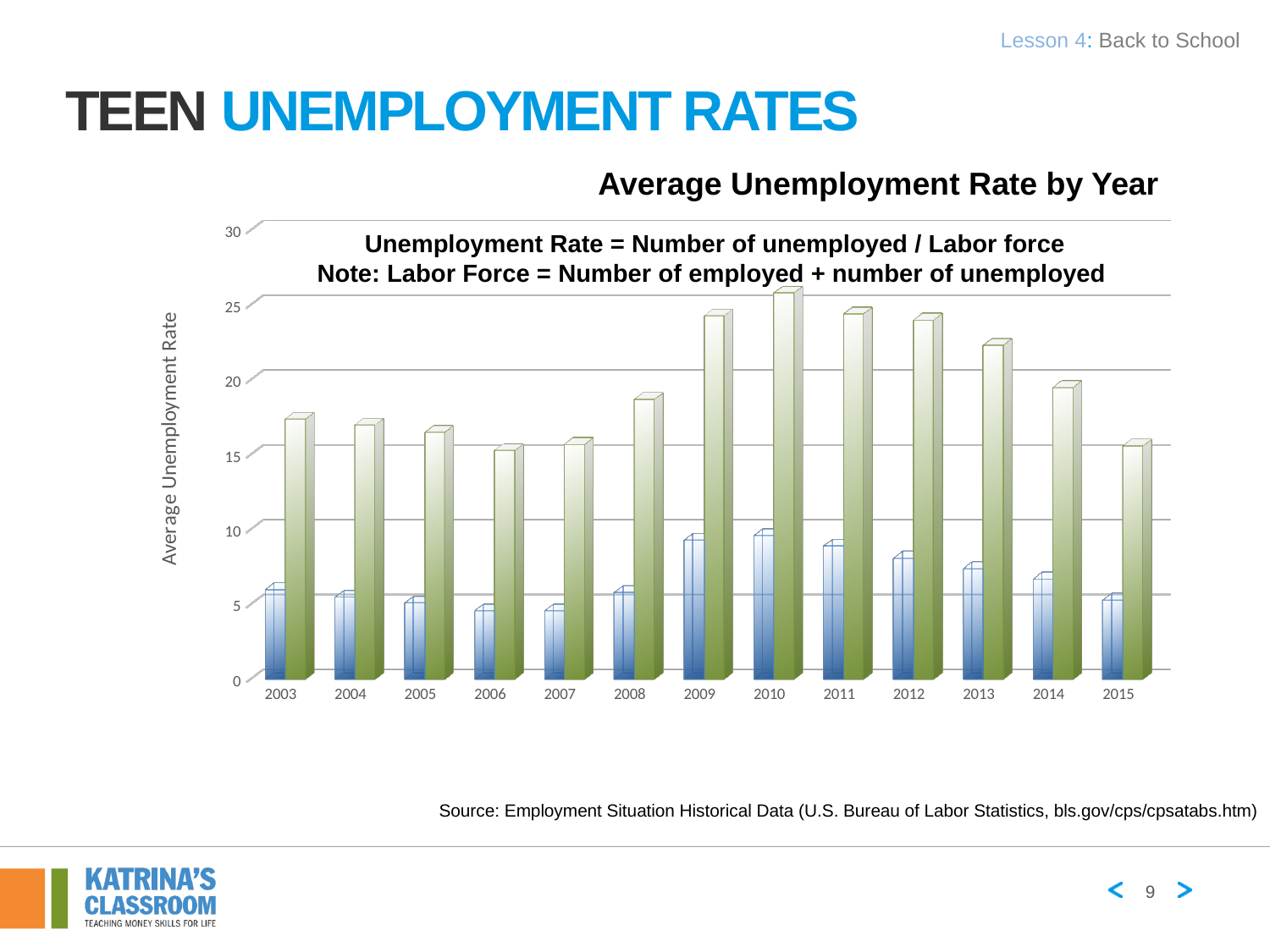
Which is taller, the blue bar for 2004 or the blue bar for 2009? 2009 How many years are shown along the x axis of the chart? 13 Is the green bar for 2006 greater or less than 20? less Do the green bars rise or fall from 2010 to 2015? fall Which is taller, the green bar for 2009 or the green bar for 2003? 2009 What kind of chart is shown on the slide? Bar chart What is the title of the chart? Average Unemployment Rate by Year What is the label on the vertical axis of the chart? Average Unemployment Rate Which year has the tallest green bar? 2010 Is the blue bar for 2003 greater or less than 10? less Is the blue bar for 2009 greater or less than 5? greater